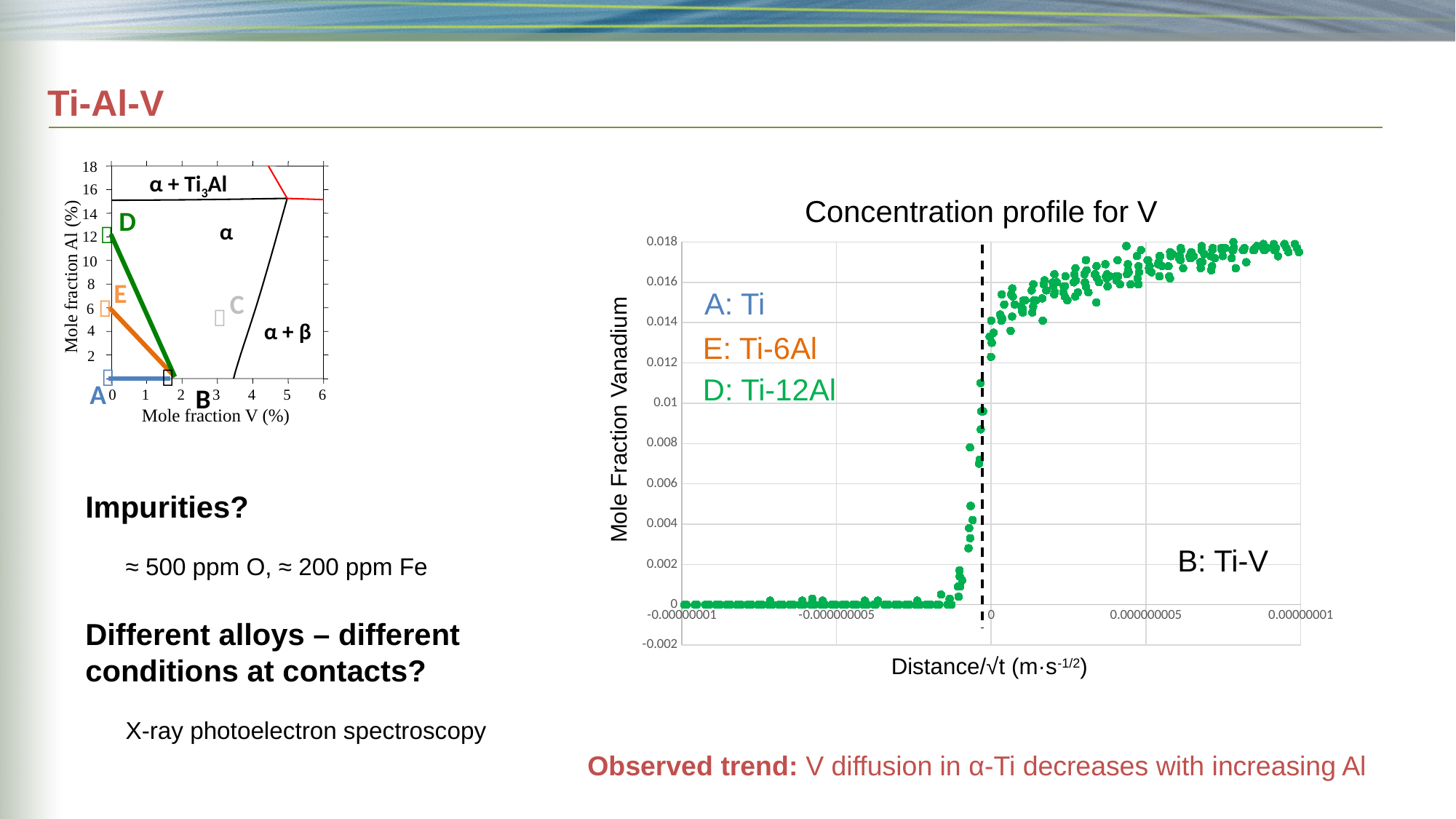
What kind of chart is the 'Concentration profile for V' chart on the right? scatter chart In the phase diagram on the left, is the Mole fraction Al for point D greater or less than 10? greater In the phase diagram on the left, what is the x-axis label? Mole fraction V (%) In the 'Concentration profile for V' chart, is the Mole Fraction Vanadium at Distance/√t = -0.000000005 greater or less than 0.002? less In the 'Concentration profile for V' chart, is the Mole Fraction Vanadium at Distance/√t = 0.00000001 greater or less than 0.016? greater What is the y-axis label of the 'Concentration profile for V' chart? Mole Fraction Vanadium In the phase diagram on the left, how many lettered alloy points (A, B, C, D, E) are marked? 5 In the 'Concentration profile for V' chart, do the plotted values rise or fall as the x axis increases from left to right? rise What is the highest tick value shown on the y axis of the 'Concentration profile for V' chart? 0.018